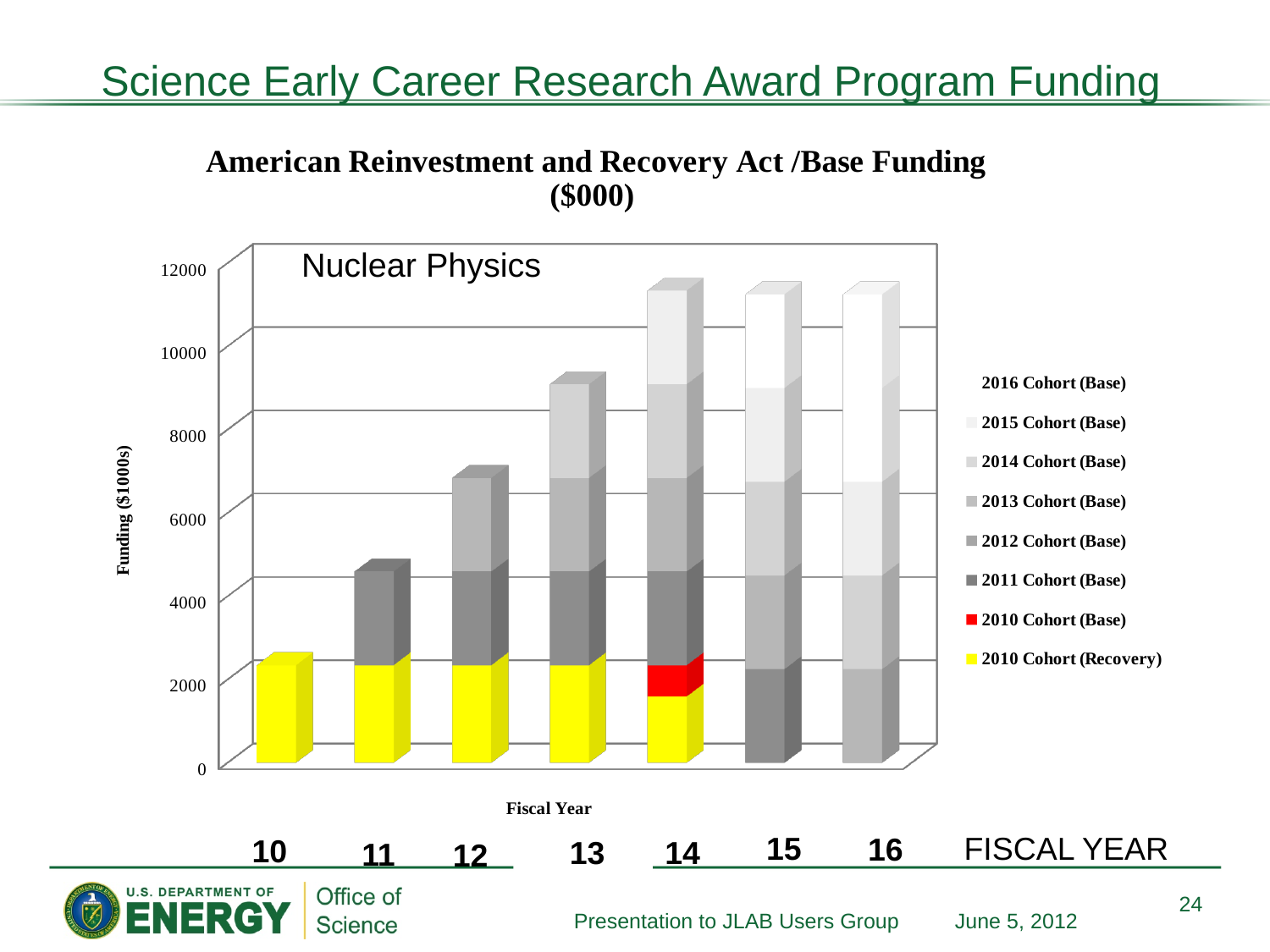
Which legend entry is shown in yellow? 2010 Cohort (Recovery) Is the total bar for fiscal year 12 greater or less than 6000? greater Is the total bar for fiscal year 14 greater or less than 10000? greater How many series does the chart's legend list? 8 Which fiscal year has the lowest total bar in the chart? 10 What kind of chart is shown on the slide? Stacked bar chart How many fiscal years are plotted along the x axis of the chart? 7 Which has the larger total bar, fiscal year 12 or fiscal year 13? Fiscal year 13 Is the total bar for fiscal year 13 greater or less than 8000? greater Do the total bar heights rise or fall from fiscal year 10 to fiscal year 14? Rise What is the label on the chart's vertical axis? Funding ($1000s)